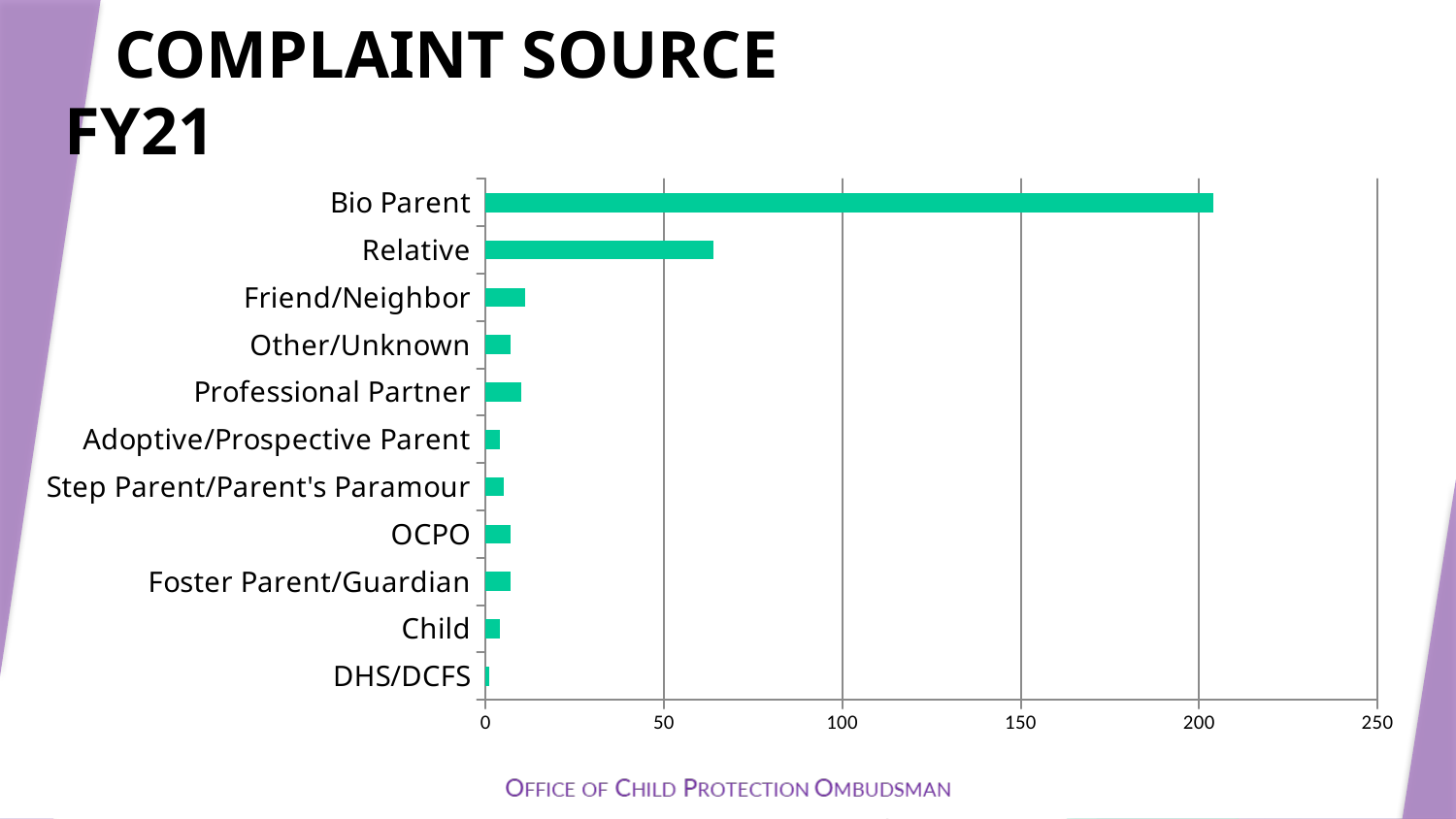
What is the title of the slide containing the chart? COMPLAINT SOURCE FY21 Which complaint source has the highest value? Bio Parent Which is larger, the value for Relative or the value for Friend/Neighbor? Relative Is the value for Bio Parent greater or less than 150? greater Which complaint source has the lowest value? DHS/DCFS Is the value for Friend/Neighbor greater or less than 50? less What is the highest value shown on the horizontal axis of the chart? 250 Is the value for Relative greater or less than 100? less How many complaint source categories are shown on the chart? 11 Which is larger, the value for Bio Parent or the value for Relative? Bio Parent What kind of chart is shown on the slide? Bar chart